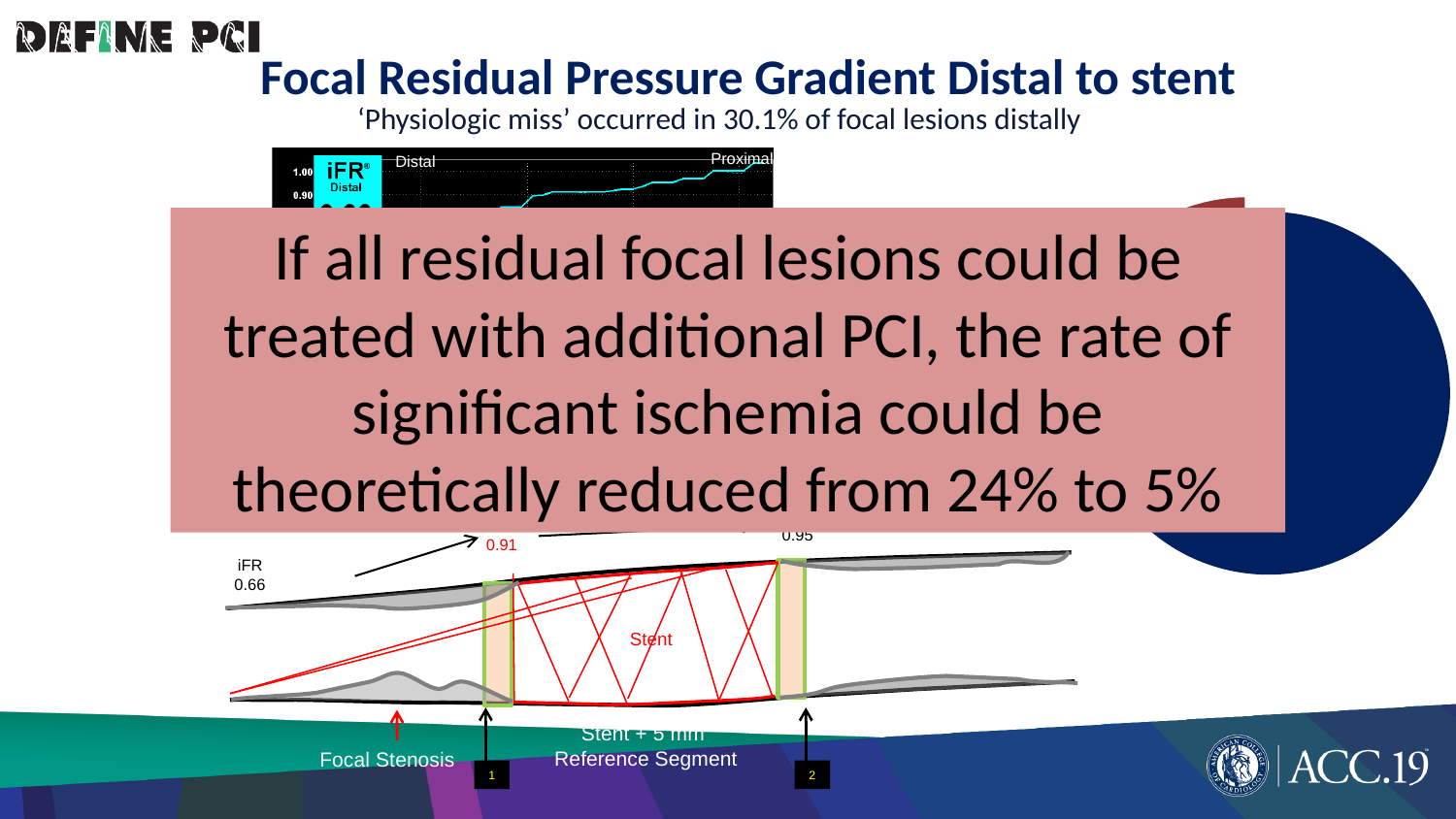
What are the two y-axis tick values visible on the iFR pullback trace? 1.00 and 0.90 What is the difference between the iFR at the distal stent edge (0.91) and the distal iFR (0.66)? 0.25 Which is larger, the iFR at the distal edge of the stent or at the proximal edge of the stent? proximal edge (0.95) What is the difference between the iFR at the proximal stent edge (0.95) and the distal stent edge (0.91)? 0.04 Is the distal iFR value of 0.66 greater or less than 0.90? less What is the distal iFR value shown on the vessel schematic? 0.66 What kind of chart is the iFR pullback trace at the top of the slide? line chart What iFR value is labelled at the distal edge of the stent? 0.91 Does the iFR pullback trace rise or fall going from distal to proximal? rises What is the title of the slide? Focal Residual Pressure Gradient Distal to stent What iFR value is labelled at the proximal edge of the stent? 0.95